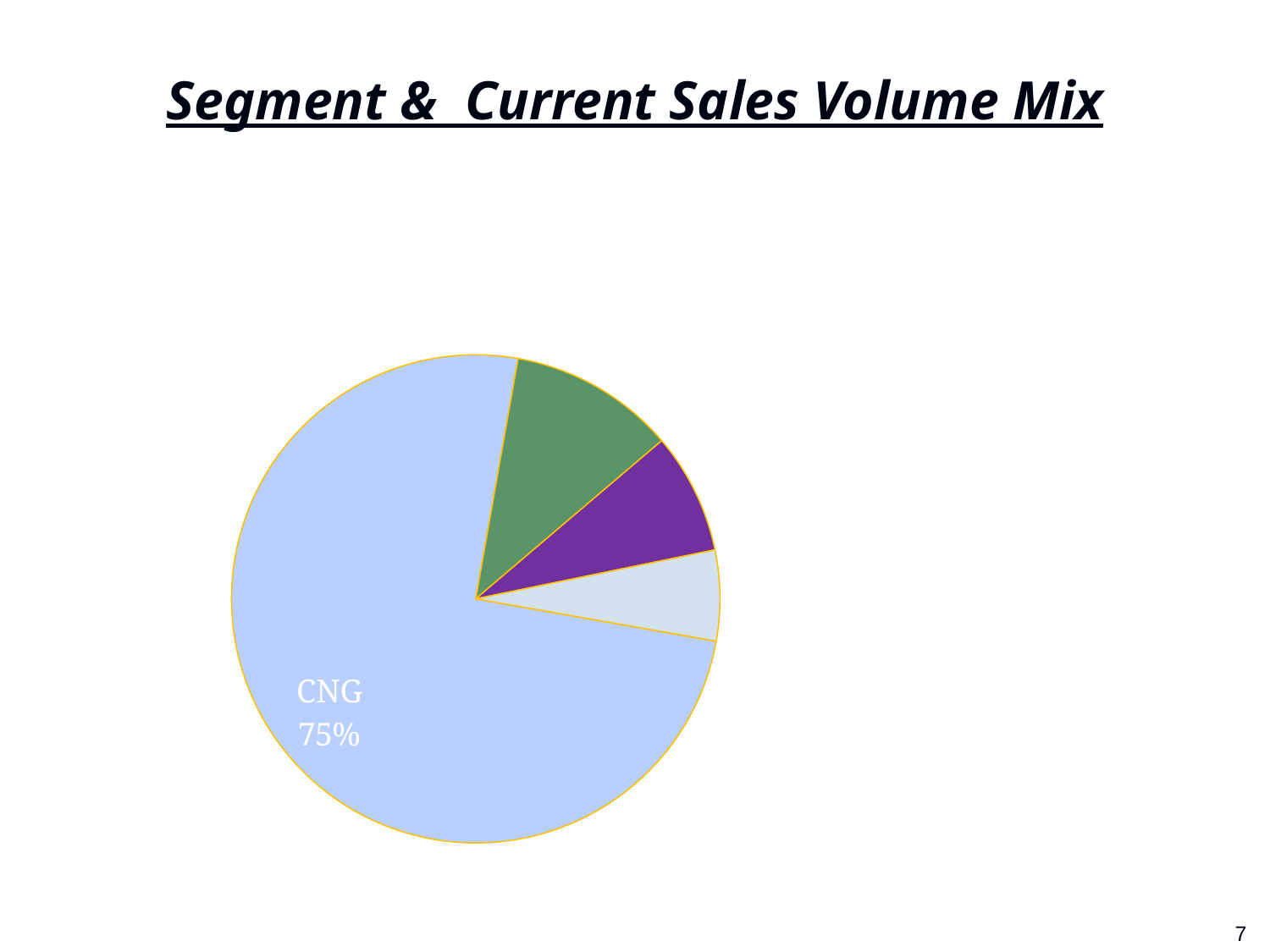
Which slice of the pie has a data label printed on it? CNG Which slice of the pie is the largest? CNG What is the title of the chart on the slide? Segment & Current Sales Volume Mix What percentage of the pie does the CNG slice represent? 75% What is the share of the pie taken by CNG? 75% What kind of chart is shown on the slide? pie chart How many slices does the pie chart have? 4 Is the CNG slice greater or less than 50% of the pie? greater